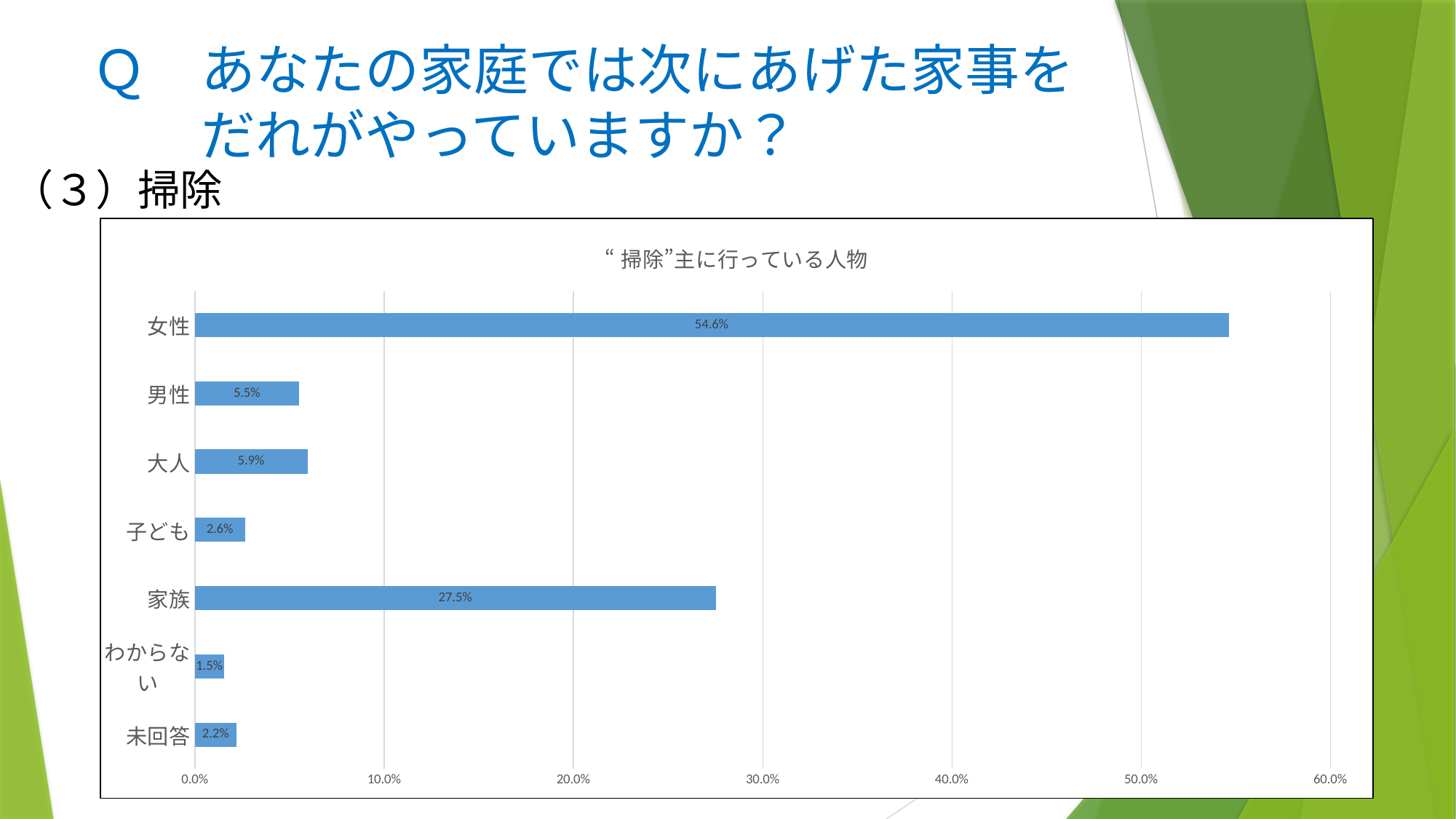
What kind of chart is shown on the slide? bar chart What is the value for 子ども? 2.6% What is the title of the chart? “掃除”主に行っている人物 What is the value for 家族? 27.5% Which is larger, the value for 未回答 or the value for わからない? 未回答 What is the difference between the values for 大人 and 男性? 0.4% Is the value for 女性 greater or less than 50.0%? greater Which category has the highest value? 女性 Which category has the lowest value? わからない How many categories are shown in the chart? 7 What is the value for 女性? 54.6% What is the difference between the values for 女性 and 家族? 27.1%